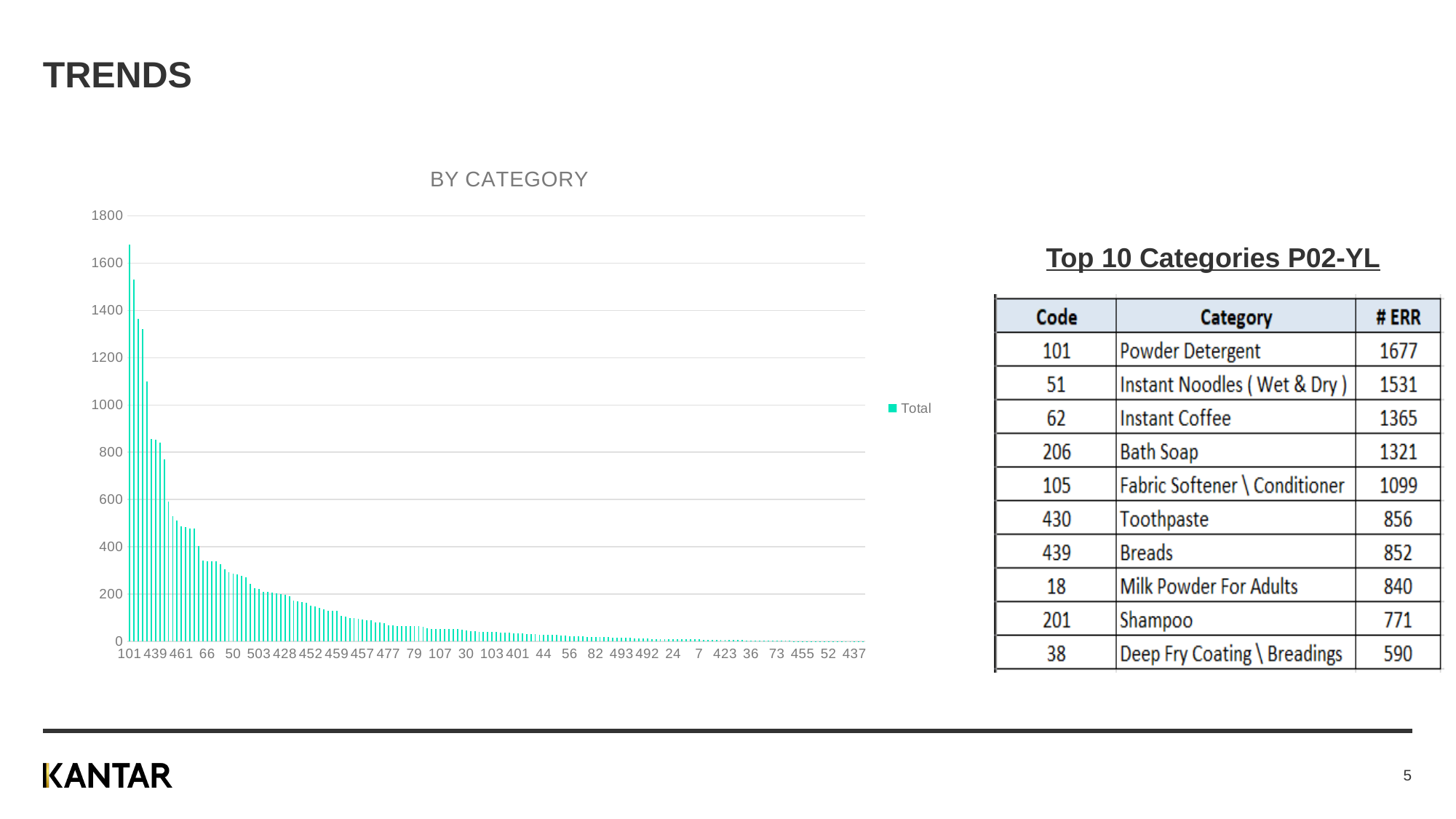
Do the values in the BY CATEGORY chart rise or fall from left to right along the x axis? fall In the BY CATEGORY chart, is the value for category 439 greater or less than 1000? less In the BY CATEGORY chart, is the value for category 437 greater or less than 200? less In the BY CATEGORY chart, which has the larger value, category 101 or category 439? 101 What kind of chart is shown under the title BY CATEGORY? Bar chart In the BY CATEGORY chart, is the value for category 101 greater or less than 1600? greater What is the title of the chart on the slide? BY CATEGORY Which category has the highest value in the BY CATEGORY chart? 101 What is the name of the series shown in the legend of the BY CATEGORY chart? Total How many series does the legend of the BY CATEGORY chart list? 1